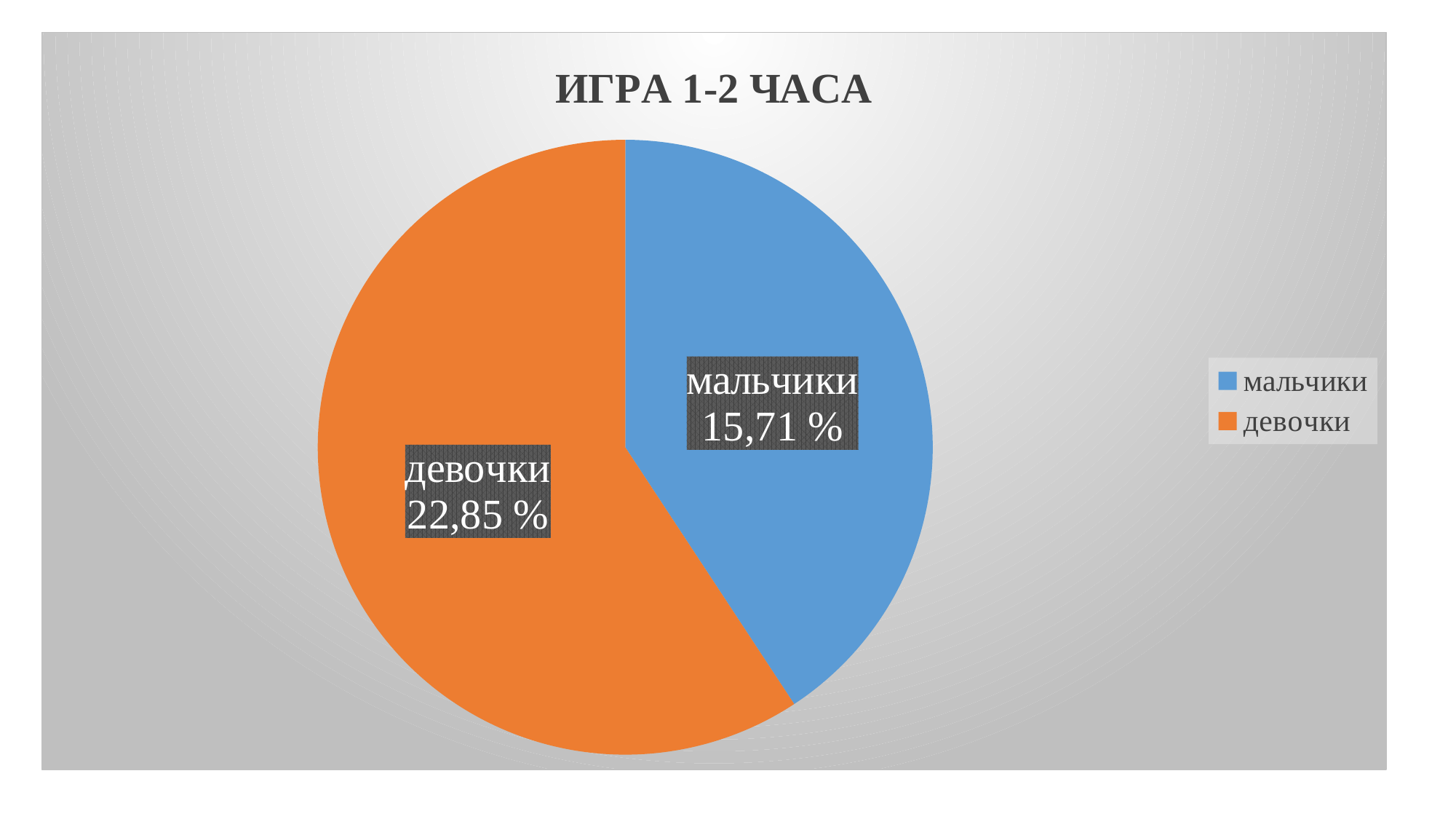
What value is shown for мальчики? 15,71 % What kind of chart is shown on the slide? pie chart What colour is the slice for девочки? orange How many entries does the legend list? 2 How many slices does the pie chart have? 2 Which is larger, the value for мальчики or the value for девочки? девочки What value is shown for девочки? 22,85 % What is the title of the chart? ИГРА 1-2 ЧАСА What is the difference between the value for девочки and the value for мальчики? 7,14 % Which category has the smallest slice of the pie? мальчики Which category has the largest slice of the pie? девочки